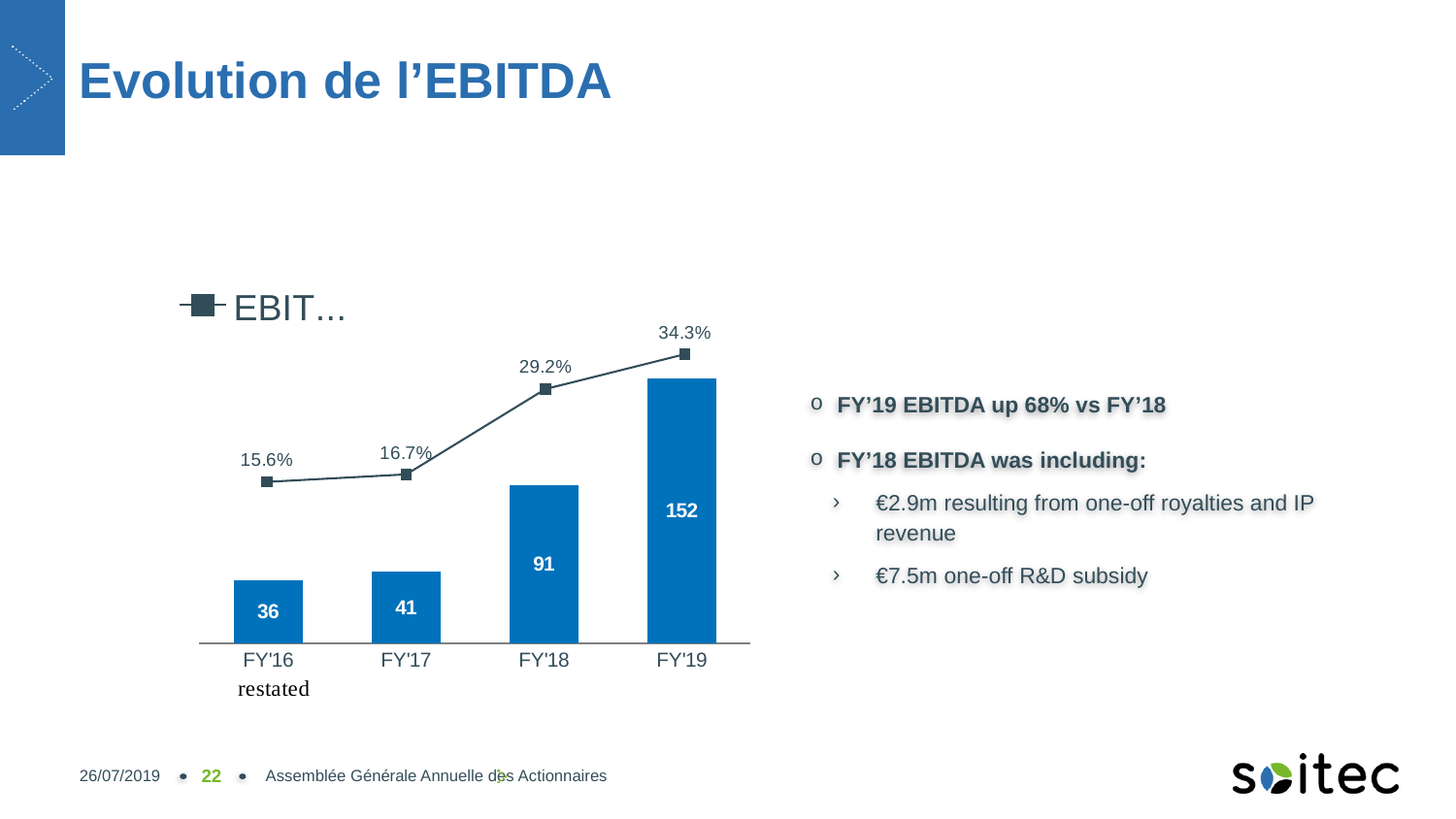
What percentage is shown on the line for FY'17? 16.7% What percentage is shown on the line for FY'16 restated? 15.6% How many fiscal years are shown on the x axis? 4 What is the difference between the line percentages for FY'19 and FY'18? 5.1% Which fiscal year has the highest EBITDA bar? FY'19 Which fiscal year has the lowest EBITDA bar? FY'16 restated What is the EBITDA bar value for FY'18? 91 What is the title of the slide containing the chart? Evolution de l'EBITDA What is the EBITDA bar value for FY'19? 152 Do the line percentages rise or fall from FY'16 restated to FY'19? rise Which is larger, the EBITDA bar for FY'17 or for FY'16 restated? FY'17 What is the difference between the FY'19 and FY'18 EBITDA bar values? 61